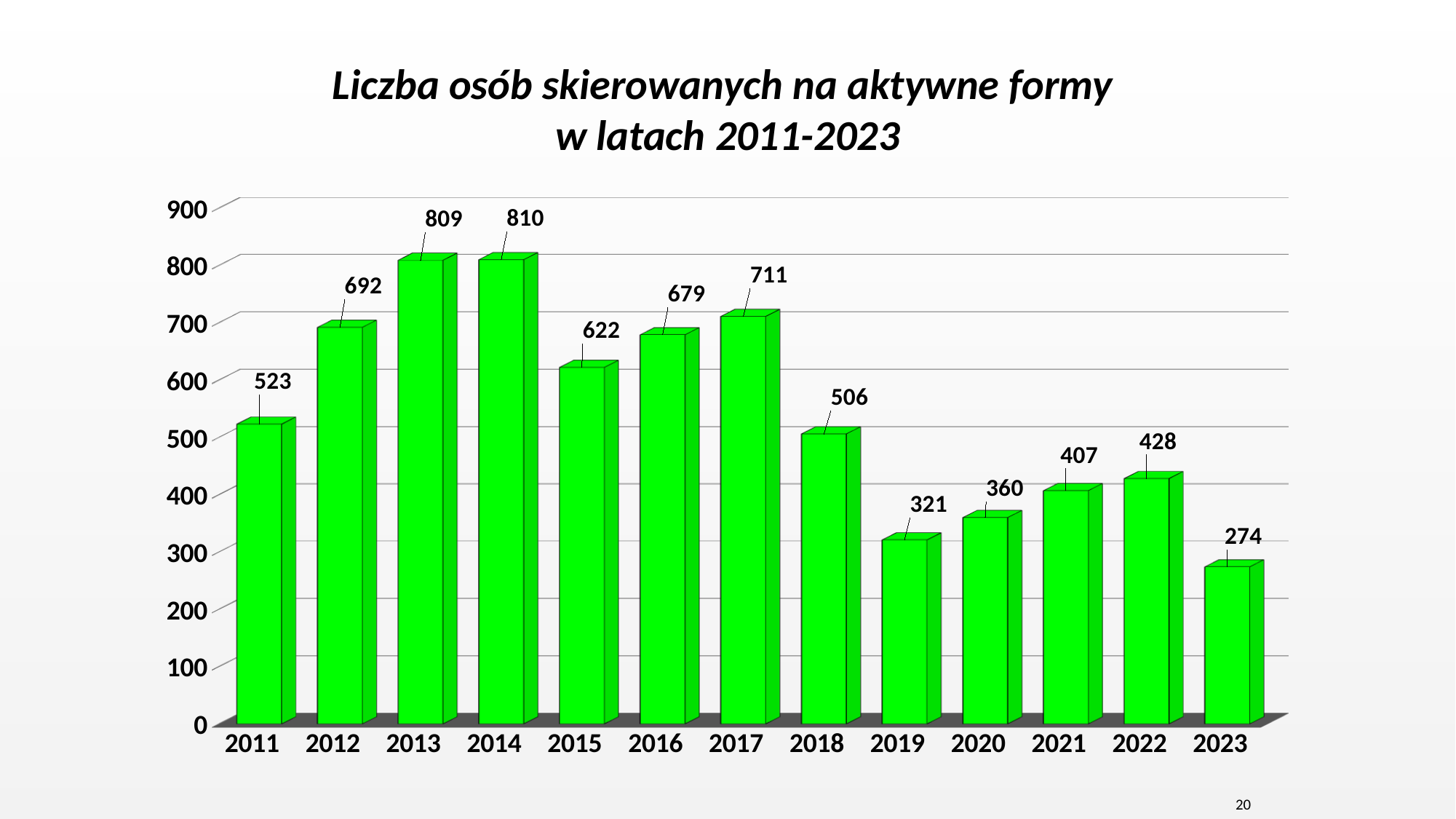
What is the difference between the values for 2018 and 2019? 185 Which is larger, the value for 2016 or the value for 2021? 2016 Which year has the lowest value? 2023 What is the value for 2020? 360 What is the value for 2011? 523 What is the value for 2017? 711 What kind of chart is shown on the slide? bar chart Is the value for 2022 greater or less than 500? less What is the difference between the values for 2012 and 2015? 70 Do the values rise or fall from 2017 to 2019? fall How many years are shown on the x axis? 13 What is the title of the chart? Liczba osób skierowanych na aktywne formy w latach 2011-2023